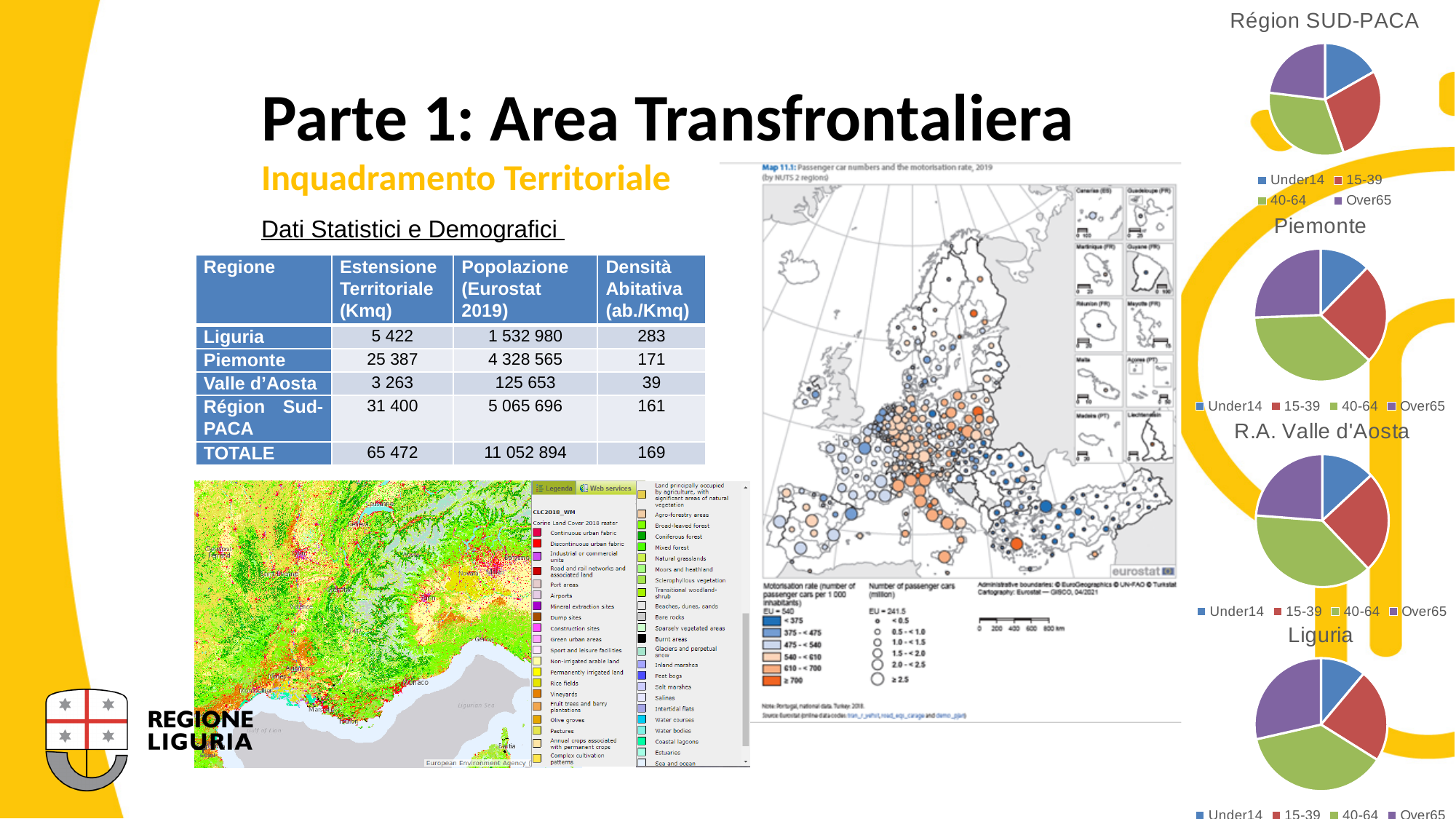
How many age-group categories does the legend of the Piemonte pie chart list? 4 What kind of chart is used for the Région SUD-PACA age distribution? Pie chart In the Région SUD-PACA pie chart, which age group has the smallest slice? Under14 In the R.A. Valle d'Aosta pie chart, which age group has the largest slice? 40-64 In the Piemonte pie chart, which age group has the largest slice? 40-64 In the Région SUD-PACA pie chart, which age group has the largest slice? 40-64 In the Liguria pie chart, which slice is larger: Under14 or 40-64? 40-64 In the Piemonte pie chart, which age group has the smallest slice? Under14 In the Liguria pie chart, which age group has the smallest slice? Under14 What colour represents the 40-64 age group in the pie charts? Green In the R.A. Valle d'Aosta pie chart, which slice is larger: Under14 or 15-39? 15-39 How many pie charts showing age groups are on the right side of the slide? 4